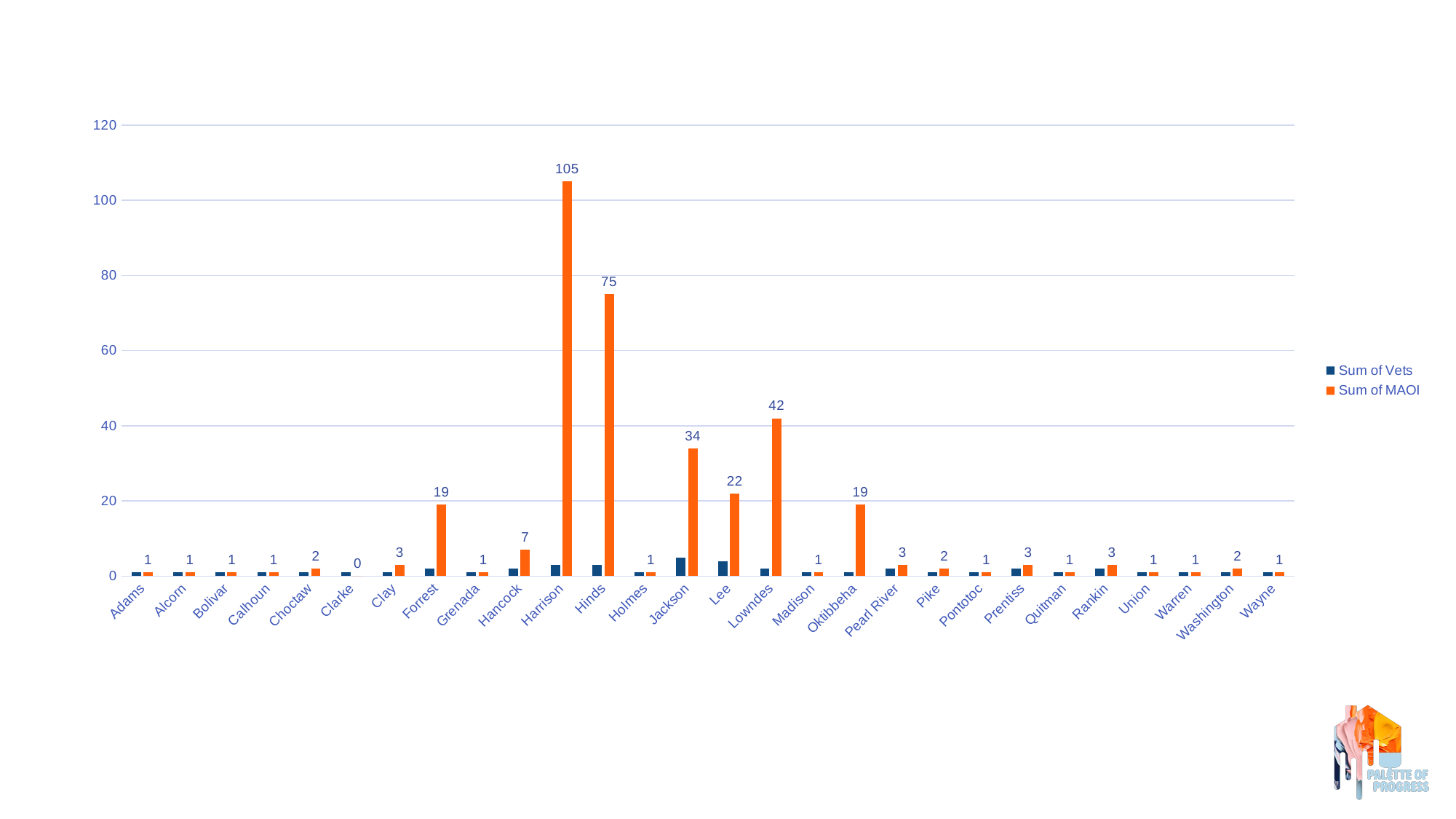
Which county has the lowest Sum of MAOI value? Clarke How many series does the legend list? 2 What is the Sum of MAOI value for Lowndes? 42 Which series is shown in orange? Sum of MAOI Which county has the highest Sum of MAOI value? Harrison Which has a larger Sum of MAOI value, Jackson or Lee? Jackson What is the difference between the Sum of MAOI values for Harrison and Hinds? 30 What is the Sum of MAOI value for Harrison? 105 Is the Sum of Vets value for Jackson greater or less than 20? less How many counties are shown on the x axis? 28 What kind of chart is shown on the slide? bar chart What is the Sum of MAOI value for Forrest? 19